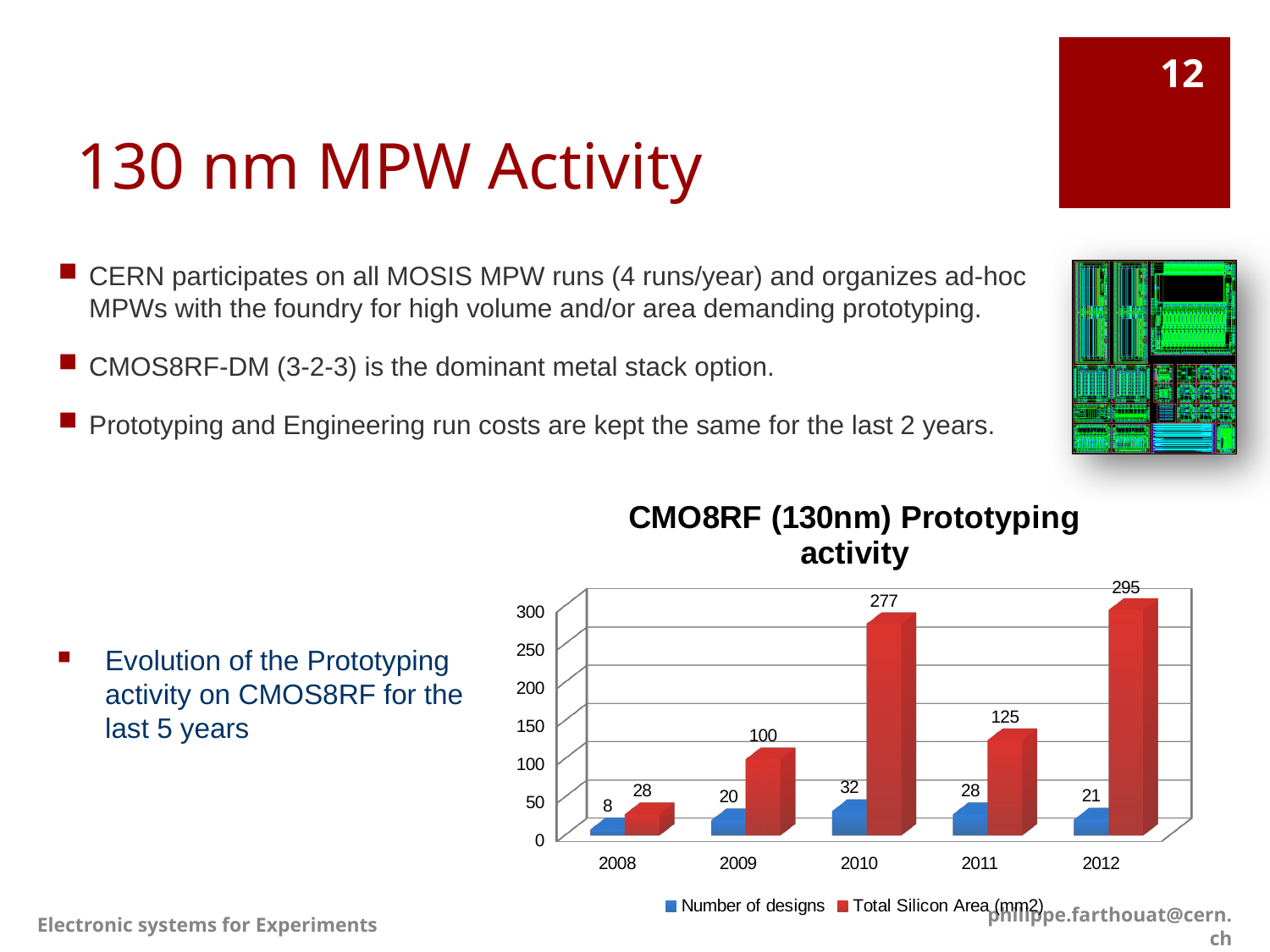
Which year has the highest Total Silicon Area (mm2)? 2012 Which year has the lowest Number of designs? 2008 What kind of chart is shown on the slide? bar chart What is the Total Silicon Area (mm2) in 2009? 100 What is the title of the chart? CMO8RF (130nm) Prototyping activity Is the Total Silicon Area (mm2) for 2010 greater or less than 250? greater What is the Total Silicon Area (mm2) in 2012? 295 How many series does the legend list? 2 How many years are shown on the x axis? 5 What is the difference in Total Silicon Area (mm2) between 2010 and 2011? 152 Which is larger, the Number of designs in 2011 or in 2012? 2011 What is the Number of designs in 2010? 32